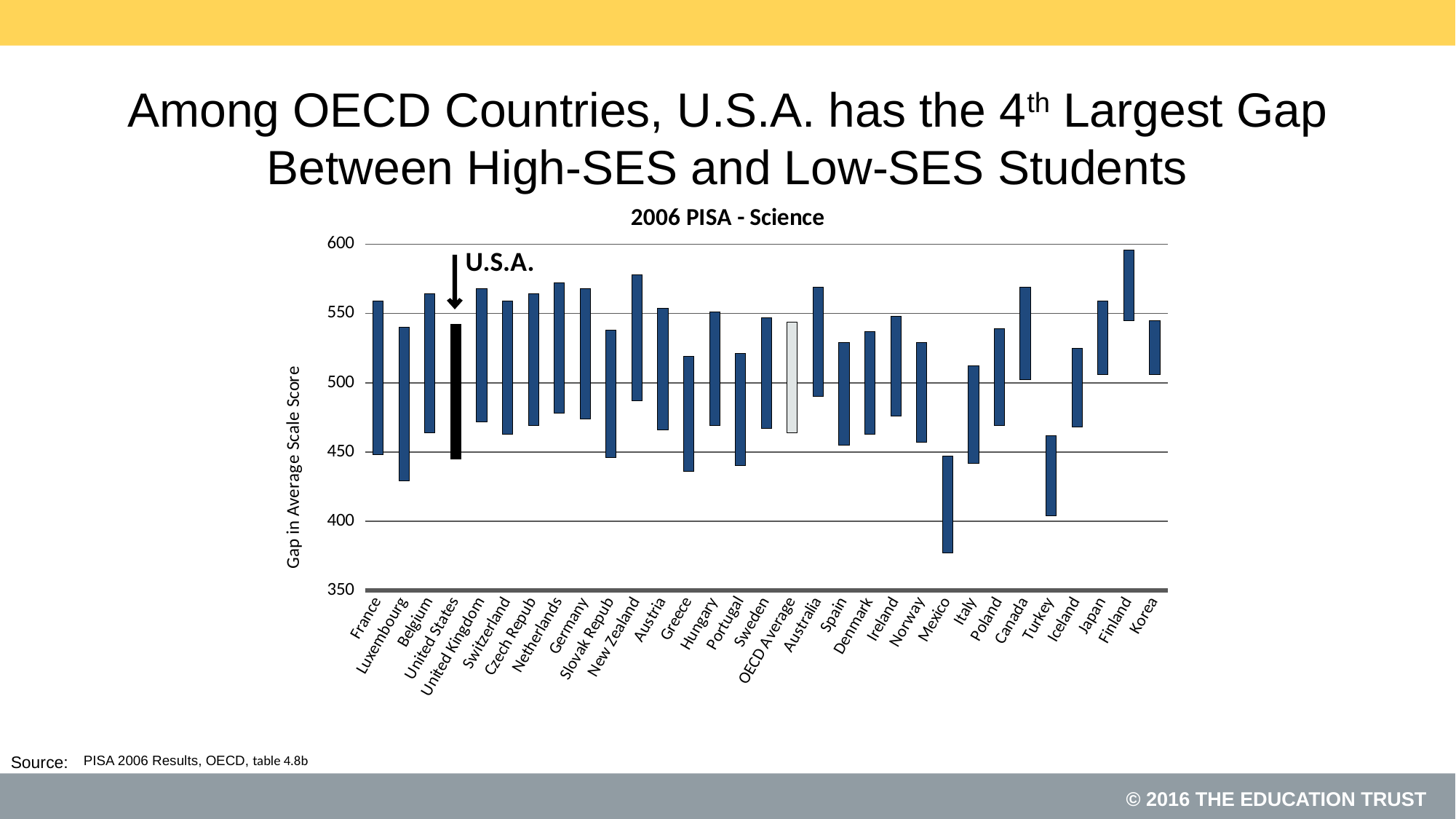
Which bar extends lower, Mexico or Turkey? Mexico What is the title of the chart? 2006 PISA - Science Is the lower end of the bar for Mexico greater or less than 400? less Which country's bar reaches the highest point on the chart? Finland What kind of chart is shown on the slide? bar chart Is the lower end of the bar for Korea greater or less than 500? greater Is the upper end of the bar for Finland greater or less than 550? greater How many categories are shown along the x axis of the chart? 31 Which country's bar is drawn in black? United States Which country's bar extends to the lowest point on the chart? Mexico